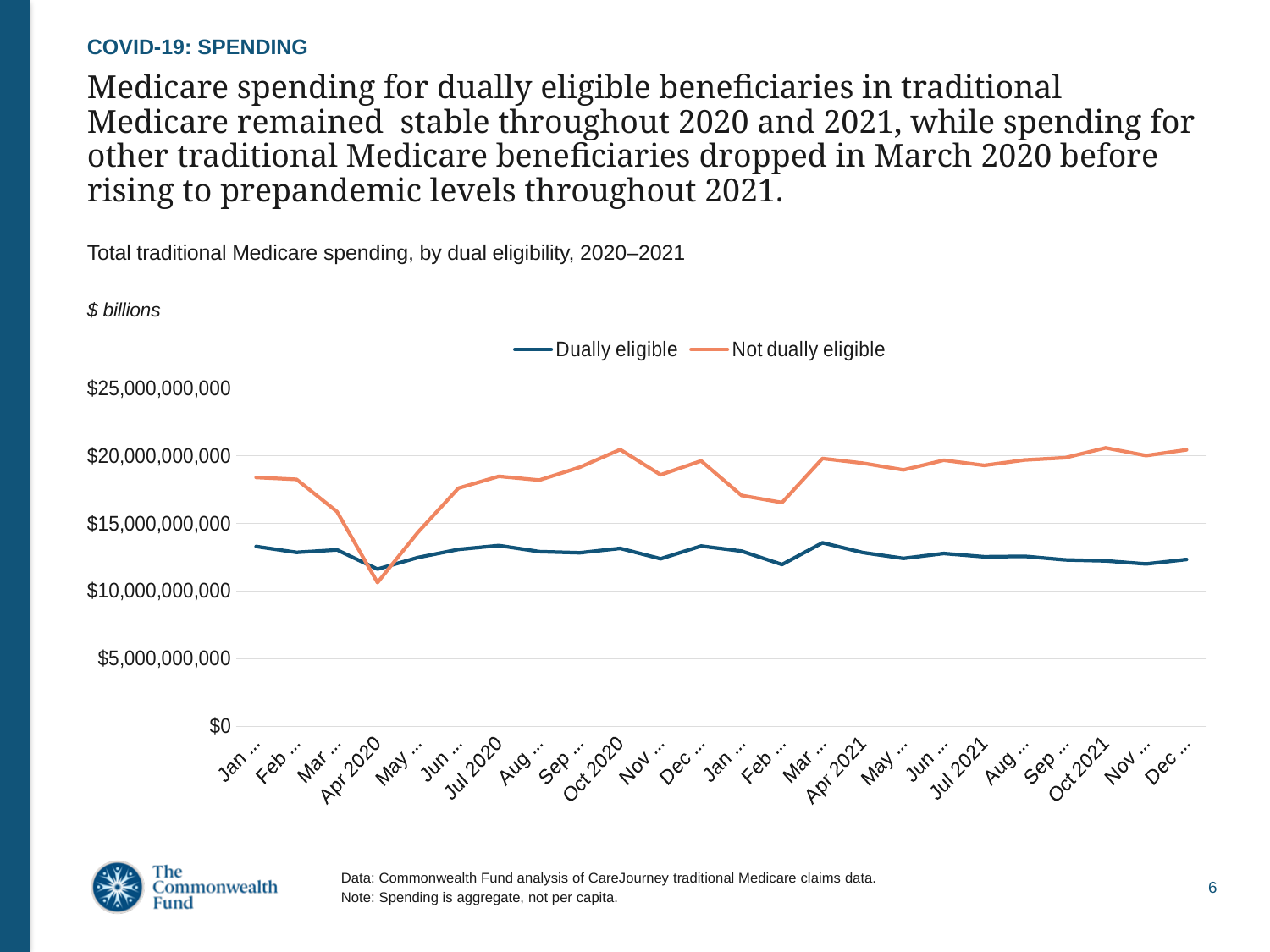
In which month does the Not dually eligible series reach its lowest value? Apr 2020 Is the value for Not dually eligible in Oct 2020 greater or less than $15,000,000,000? greater Is the value for Not dually eligible in Apr 2020 greater or less than $15,000,000,000? less Which series has the higher value in Jul 2021, Dually eligible or Not dually eligible? Not dually eligible Does the Not dually eligible series rise or fall between Apr 2020 and Jul 2020? Rise How many series does the legend list? 2 What unit is shown for the y axis? $ billions Is the value for Dually eligible in Jul 2020 greater or less than $15,000,000,000? less What are the two series named in the legend? Dually eligible; Not dually eligible Which series has the higher value in Apr 2020, Dually eligible or Not dually eligible? Dually eligible What kind of chart is shown on the slide? Line chart